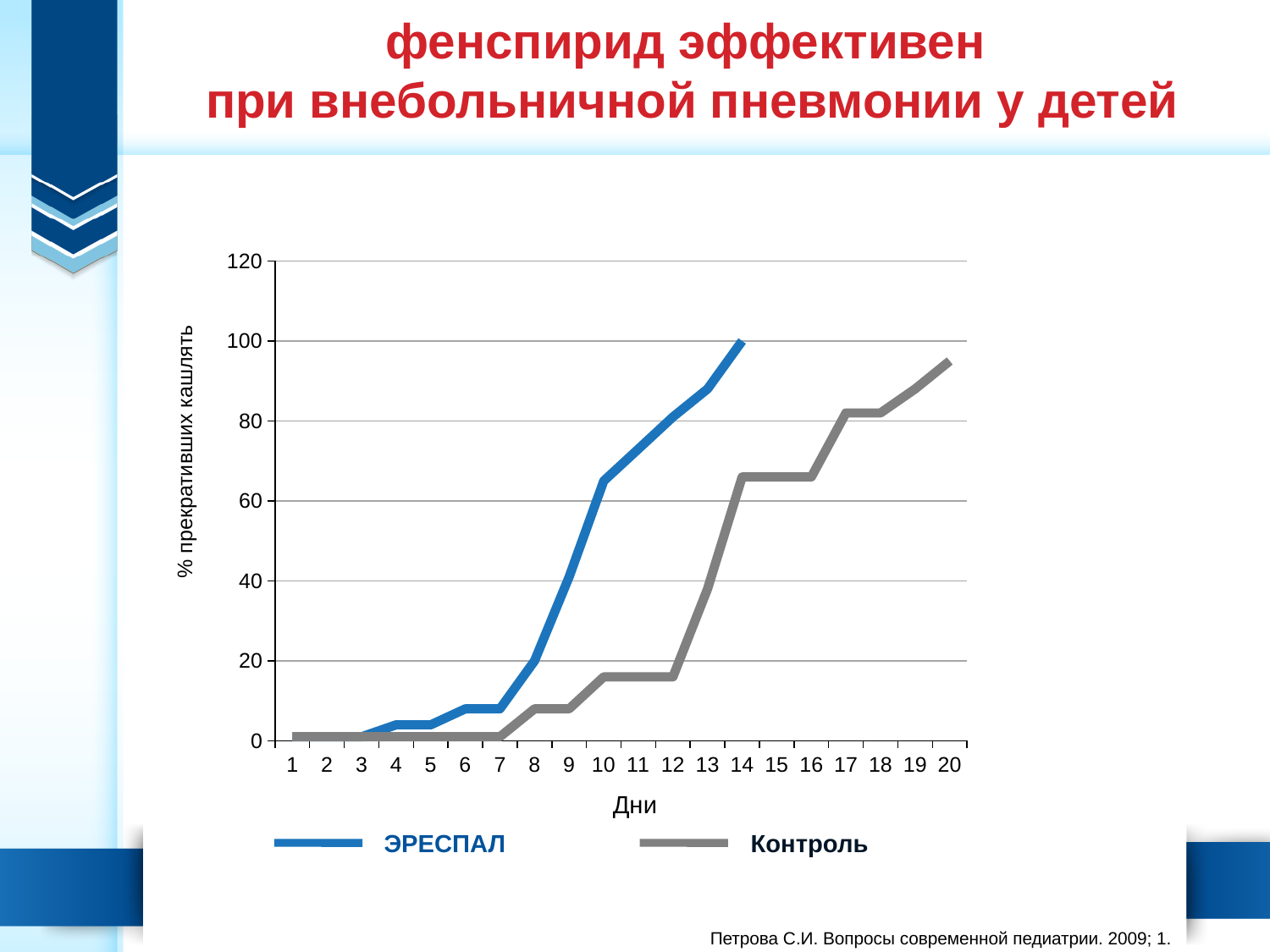
On day 10, which series has the higher value, ЭРЕСПАЛ or Контроль? ЭРЕСПАЛ Is the value for Контроль on day 20 greater or less than 100? less Do the values for Контроль rise or fall as the days increase? rise Is the value for ЭРЕСПАЛ on day 13 greater or less than 80? greater What are the two series named in the legend? ЭРЕСПАЛ and Контроль Is the value for Контроль on day 10 greater or less than 20? less What value does the ЭРЕСПАЛ line reach on day 14? 100 What is the title of the x axis? Дни What kind of chart is shown on the slide? line chart How many days are marked along the x axis? 20 How many series does the legend list? 2